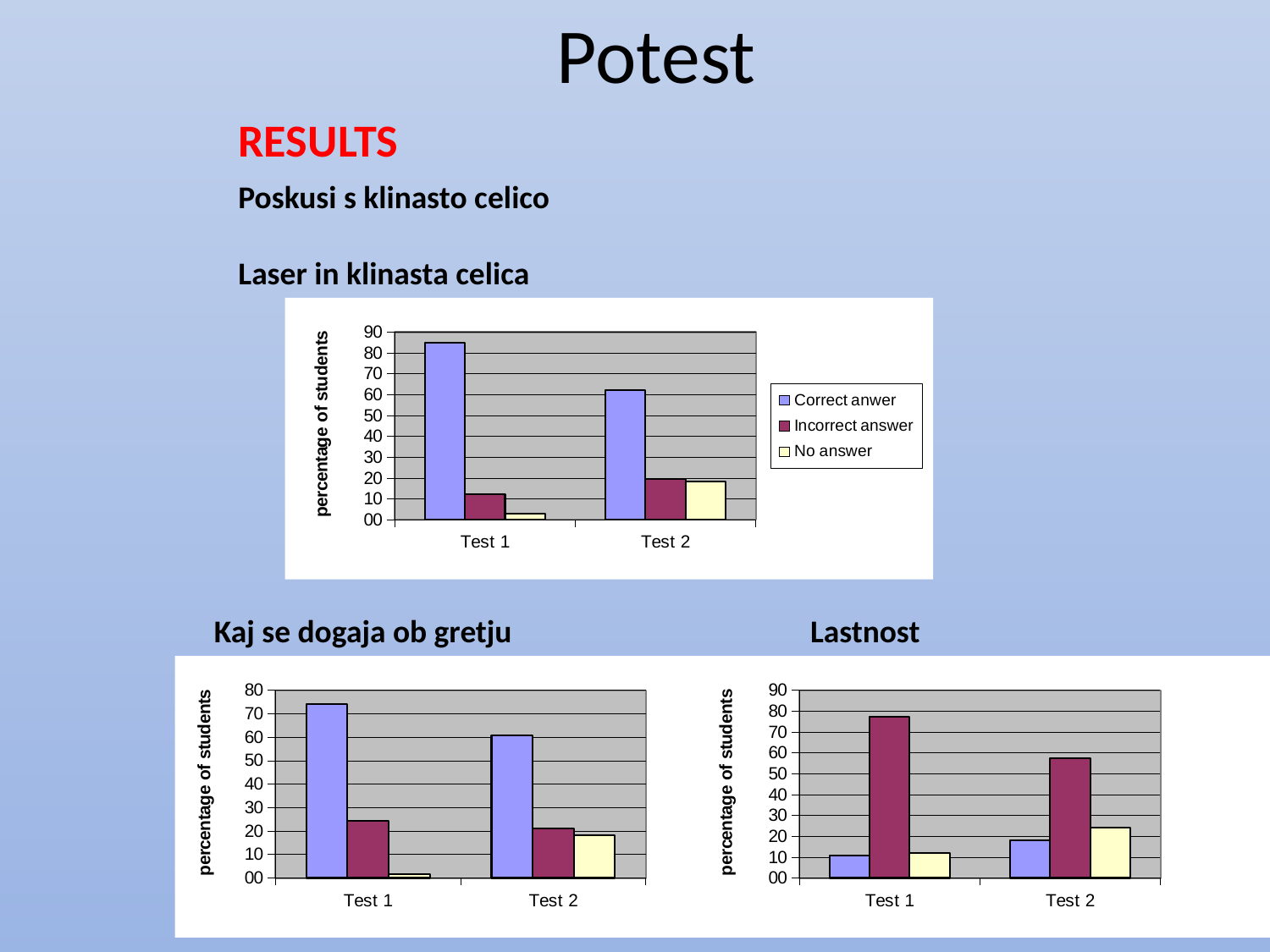
In the 'Kaj se dogaja ob gretju' chart, is the No answer value for Test 1 greater or less than 10? less In the 'Laser in klinasta celica' chart, which test has the higher Correct answer value? Test 1 In the 'Lastnost' chart, is the Incorrect answer value for Test 1 greater or less than 70? greater In the 'Laser in klinasta celica' chart, does the Correct answer value rise or fall from Test 1 to Test 2? fall In the 'Kaj se dogaja ob gretju' chart, is the Correct answer value for Test 2 greater or less than 50? greater In the 'Lastnost' chart, which series has the highest value for Test 1? Incorrect answer What type of chart is the 'Laser in klinasta celica' chart? bar chart What is the y-axis label of the 'Laser in klinasta celica' chart? percentage of students How many categories are shown on the x axis of the 'Laser in klinasta celica' chart? 2 How many series does the legend of the 'Laser in klinasta celica' chart list? 3